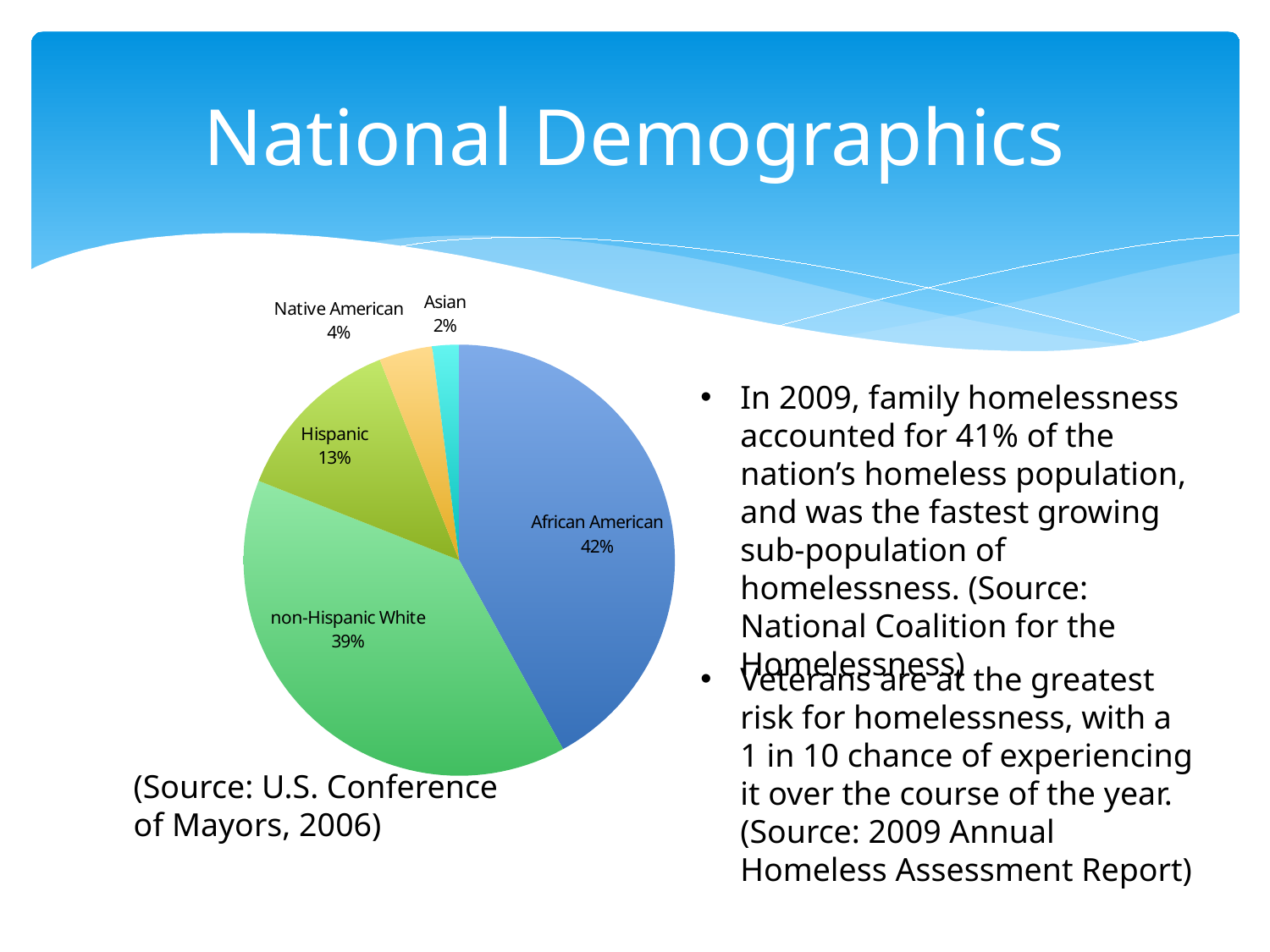
What is the value shown for non-Hispanic White? 39% Which is larger, the Hispanic share or the Native American share? Hispanic What source is cited below the pie chart? U.S. Conference of Mayors, 2006 How many categories are shown in the pie chart? 5 What share of the pie does African American represent? 42% What is the value shown for Native American? 4% Which category has the largest slice of the pie? African American What kind of chart is shown on the slide? pie chart What is the value shown for Asian? 2% What is the difference between the African American and non-Hispanic White shares? 3% Which category has the smallest slice of the pie? Asian What is the value shown for Hispanic? 13%